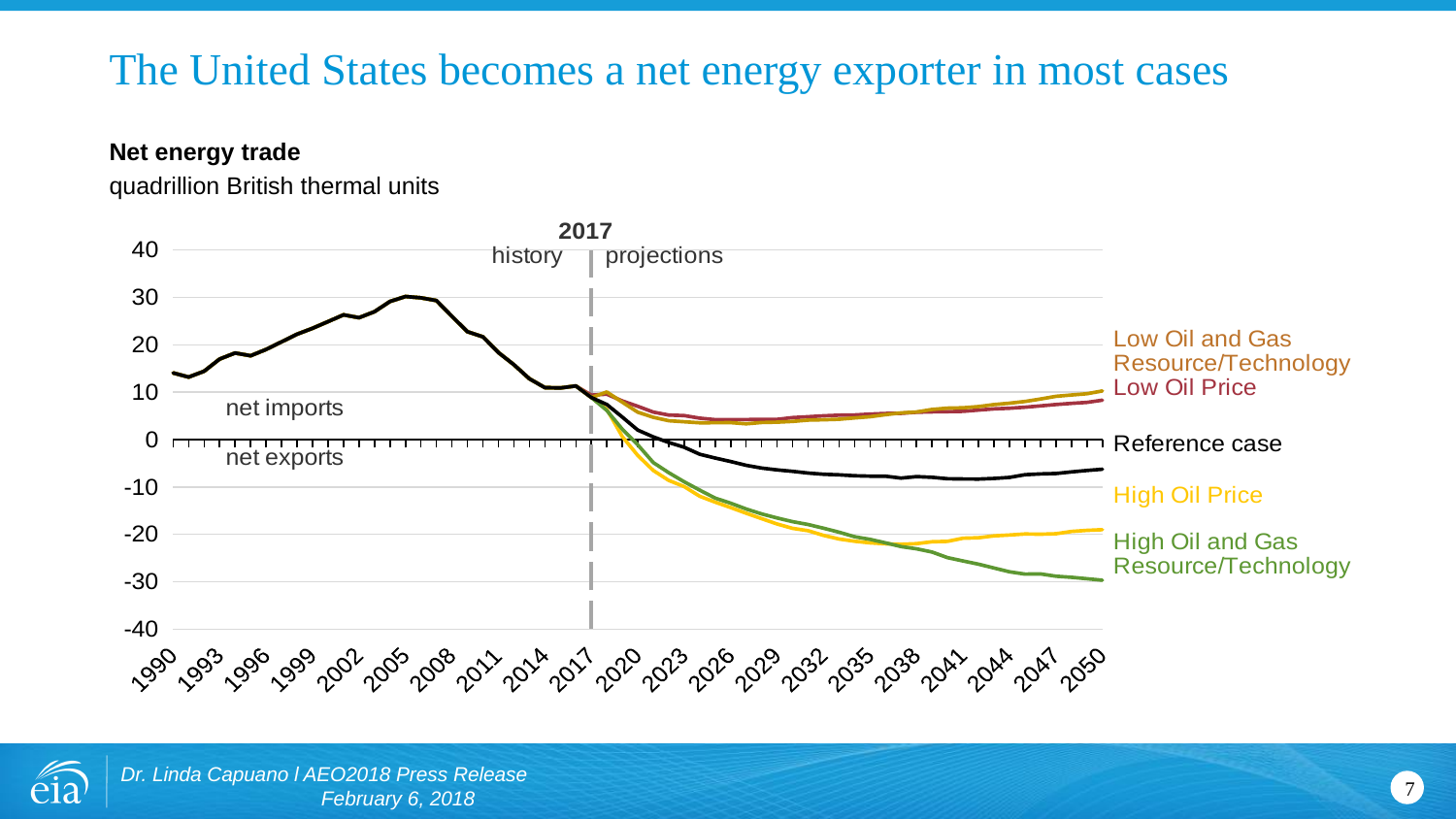
Does the Reference case line rise or fall overall from 2017 to 2050? fall In 2050, is the value for the Reference case greater or less than -10? greater In 2050, is the value for the Low Oil and Gas Resource/Technology case greater or less than 0? greater Which case has the lowest value in 2050? High Oil and Gas Resource/Technology In 2050, is the value for the High Oil Price case greater or less than -10? less What year separates history from projections on the chart? 2017 In 2050, which is higher: the High Oil Price case or the High Oil and Gas Resource/Technology case? High Oil Price In 2050, which is higher: the Low Oil Price case or the Reference case? Low Oil Price How many projection cases are labelled on the chart? 5 What kind of chart is shown on the slide? line chart What is the title of the chart? Net energy trade